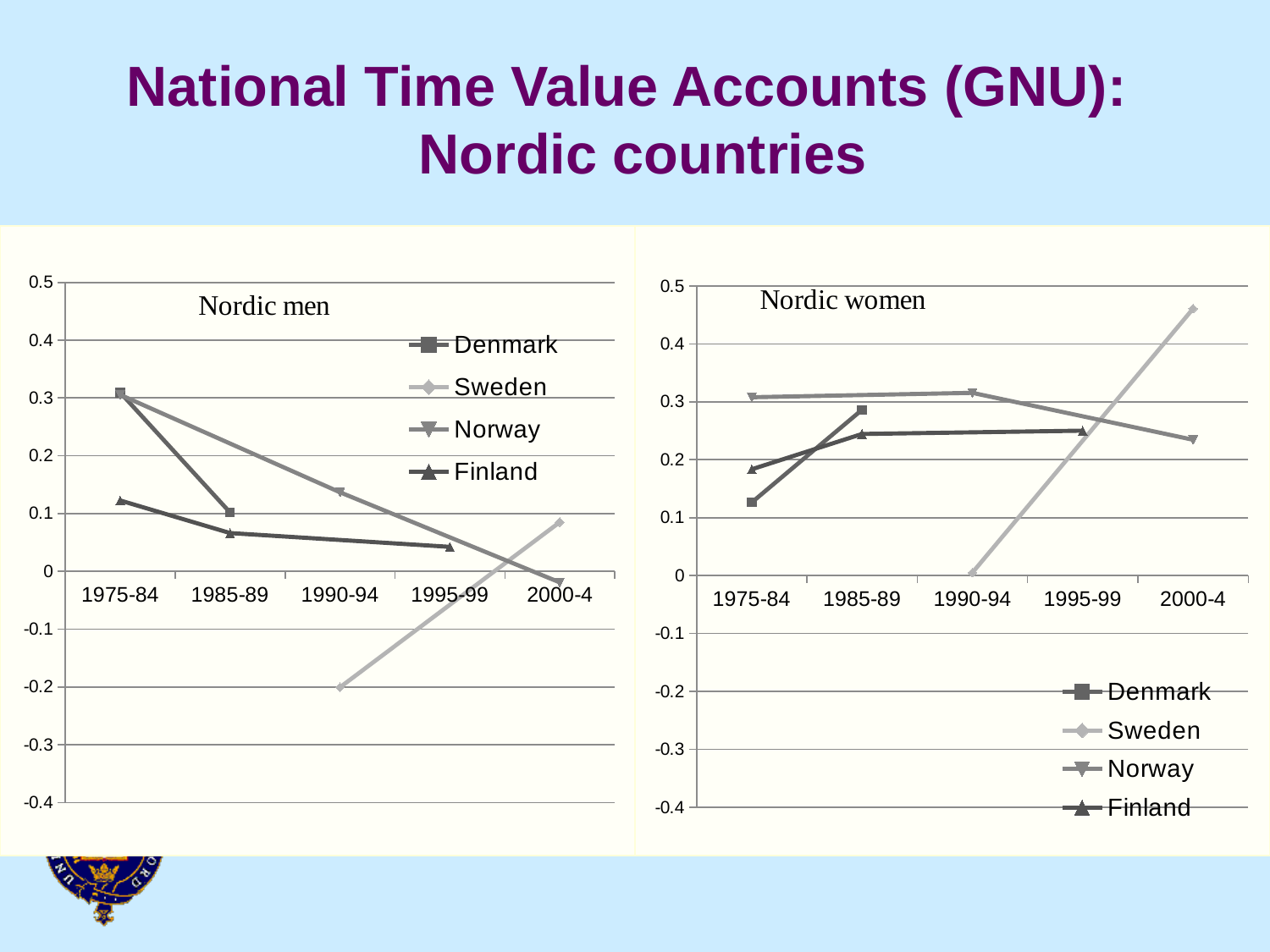
Which countries are listed in the legend of the Nordic men chart? Denmark, Sweden, Norway, Finland In the Nordic women chart, does the Sweden line rise or fall from 1990-94 to 2000-4? rise How many series does the legend of the Nordic women chart list? 4 How many period categories are shown on the x axis of the Nordic men chart? 5 In the Nordic men chart, which is larger for Denmark: the value in 1975-84 or in 1985-89? 1975-84 In the Nordic women chart, which is larger for Denmark: the value in 1975-84 or in 1985-89? 1985-89 In the Nordic women chart, is the value for Sweden in 2000-4 greater or less than 0.4? greater In the Nordic men chart, does the Norway line rise or fall from 1975-84 to 2000-4? fall In the Nordic men chart, is the value for Sweden in 1990-94 greater or less than -0.1? less In the Nordic men chart, is the value for Denmark in 1975-84 greater or less than 0.2? greater What kind of chart is the Nordic men chart? line chart